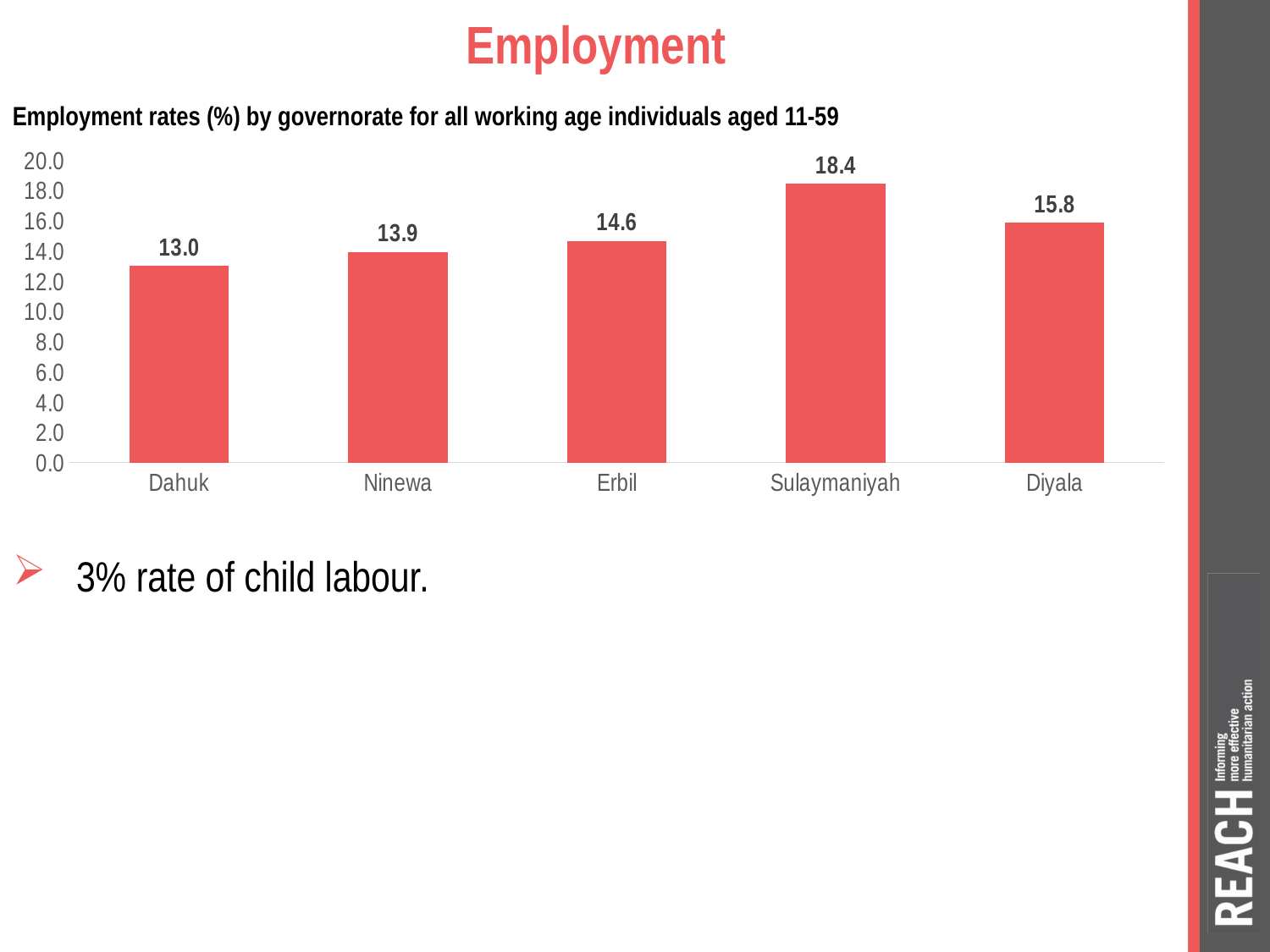
What is the employment rate for Dahuk? 13.0 Which governorate has the highest employment rate? Sulaymaniyah How many governorates are shown in the chart? 5 What kind of chart is shown on the slide? bar chart Is the employment rate for Ninewa greater or less than 16.0? less What is the difference between the employment rates of Sulaymaniyah and Dahuk? 5.4 What is the difference between the employment rates of Diyala and Ninewa? 1.9 What is the title of the chart? Employment rates (%) by governorate for all working age individuals aged 11-59 Which governorate has the lowest employment rate? Dahuk What is the employment rate for Erbil? 14.6 What is the employment rate for Sulaymaniyah? 18.4 Which has a higher employment rate, Erbil or Diyala? Diyala